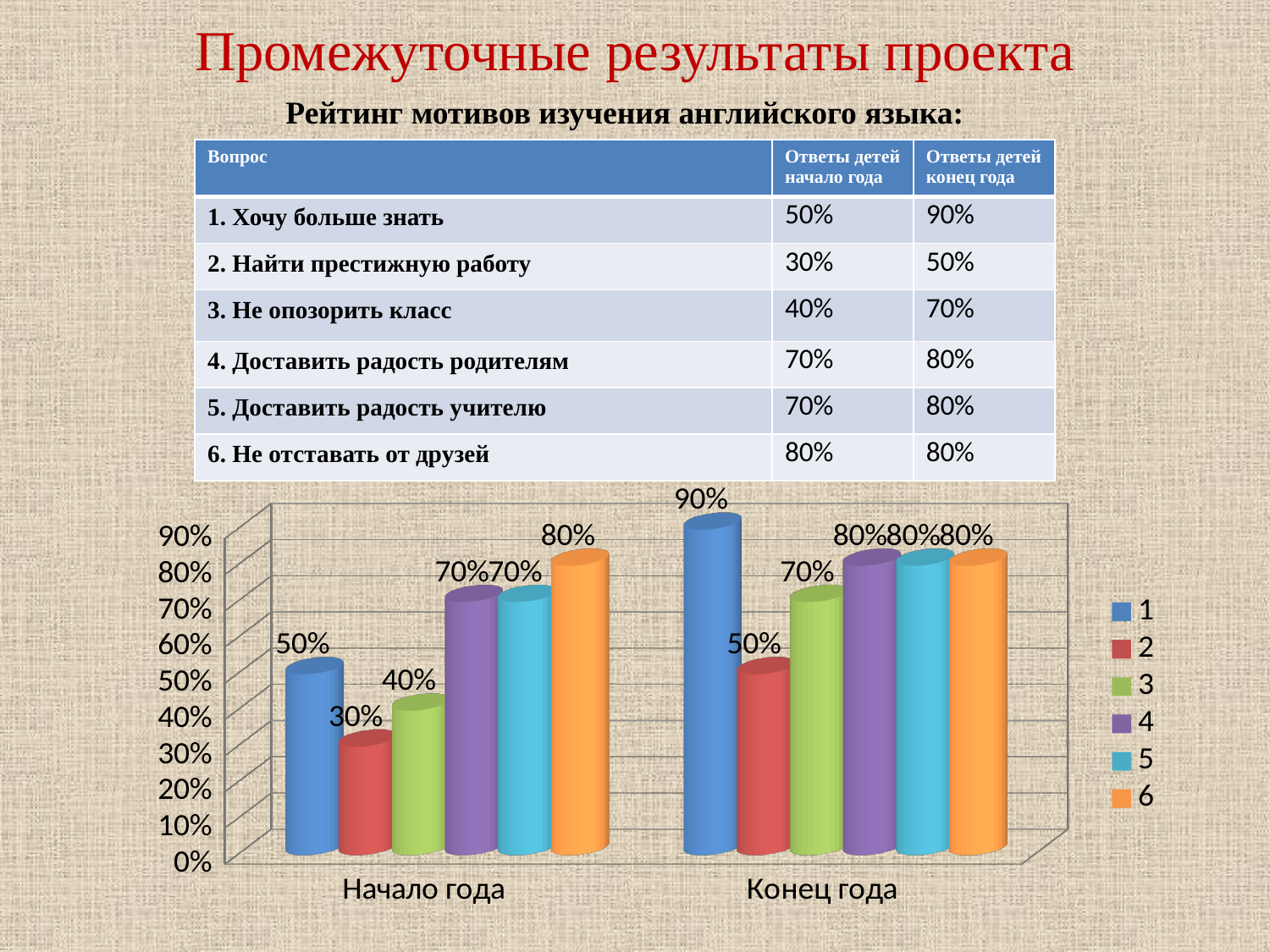
What kind of chart is shown on the slide? bar chart Does the value for series 1 rise or fall from "Начало года" to "Конец года"? rise What is the value for series 2 in the "Конец года" category? 50% What colour are the bars for series 6 in the chart? orange What is the value for series 1 in the "Начало года" category? 50% What is the difference between the value for series 1 in "Конец года" and in "Начало года"? 40% How many series does the chart legend list? 6 Which series has the highest value in the "Конец года" category? 1 How many categories are shown on the x axis of the chart? 2 What is the value for series 3 in the "Начало года" category? 40% Which series has the lowest value in the "Начало года" category? 2 Which is larger: the value for series 3 in "Начало года" or the value for series 3 in "Конец года"? Конец года